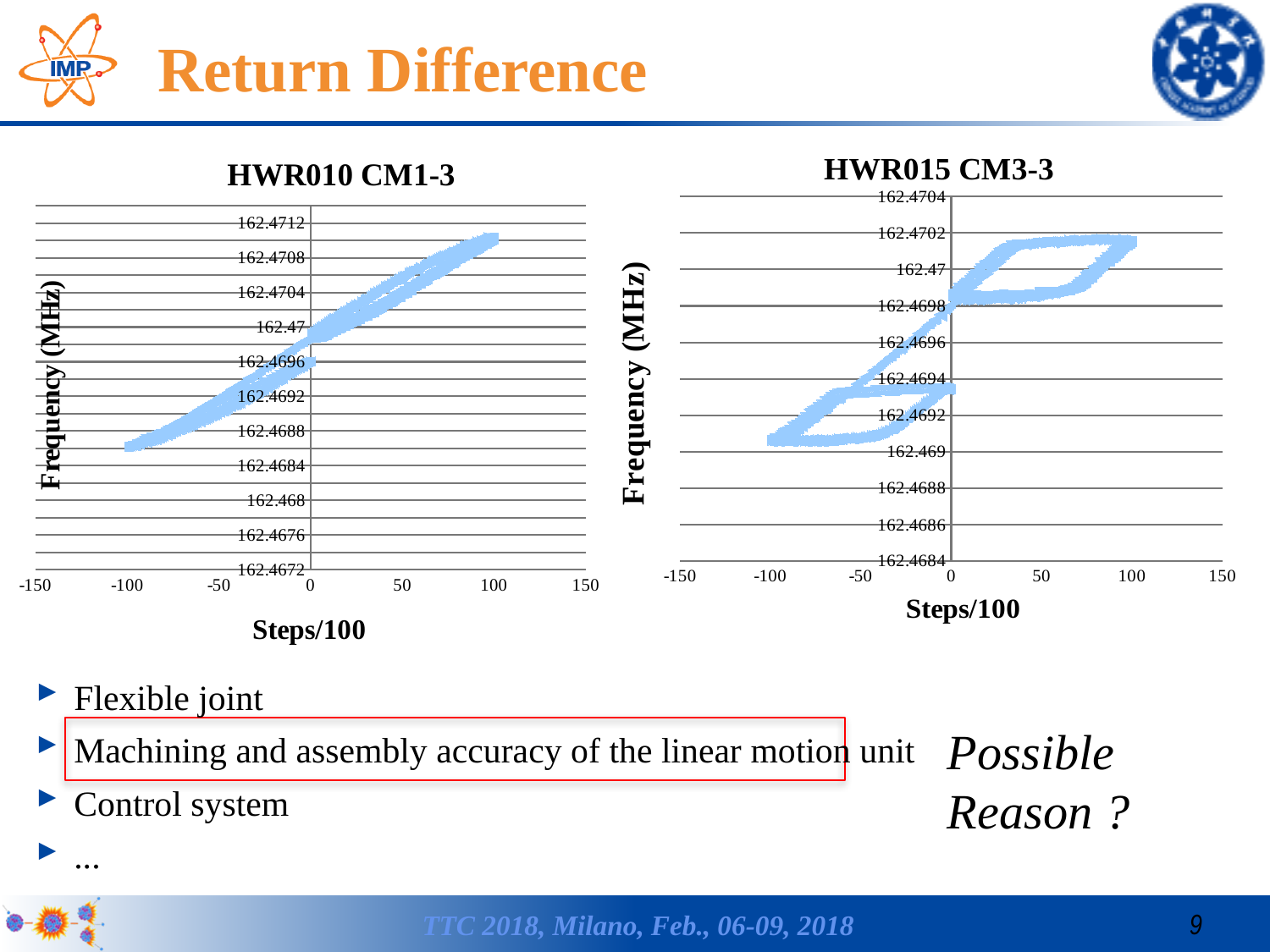
In the HWR010 CM1-3 chart, does the frequency rise or fall as Steps/100 increases from -100 to 100? rise What kind of chart is the HWR015 CM3-3 chart? scatter chart What is the y-axis label of the HWR015 CM3-3 chart? Frequency (MHz) In the HWR010 CM1-3 chart, is the frequency at Steps/100 = -100 greater or less than 162.4692 MHz? less In the HWR015 CM3-3 chart, is the frequency at Steps/100 = 100 greater or less than 162.4698 MHz? greater What is the x-axis label of the HWR010 CM1-3 chart? Steps/100 What kind of chart is the HWR010 CM1-3 chart? scatter chart In the HWR010 CM1-3 chart, is the frequency higher at Steps/100 = 100 or at Steps/100 = -100? 100 In the HWR010 CM1-3 chart, is the frequency at Steps/100 = 100 greater or less than 162.4704 MHz? greater In the HWR015 CM3-3 chart, is the frequency higher at Steps/100 = -100 or at Steps/100 = 100? 100 In the HWR015 CM3-3 chart, does the frequency rise or fall as Steps/100 increases from -100 to 100? rise